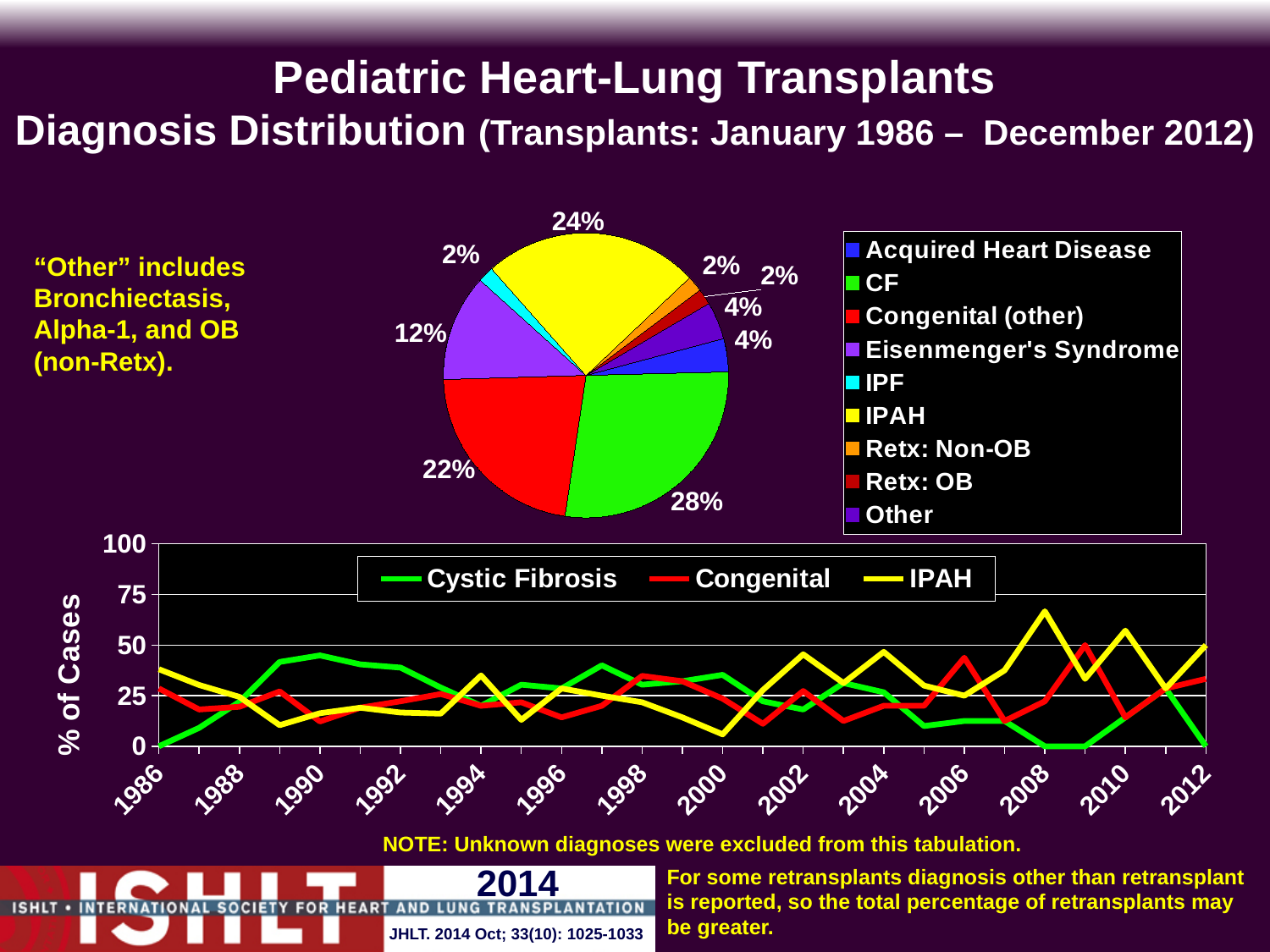
In the pie chart, which is larger, the share for Congenital (other) or the share for Eisenmenger's Syndrome? Congenital (other) In the pie chart, how many diagnosis categories does the legend list? 9 In the lower line chart, is the value for Cystic Fibrosis in 2012 greater or less than 25? less In the pie chart, which diagnosis has the largest share? CF What kind of chart is the lower chart showing % of Cases from 1986 to 2012? Line chart In the pie chart, what share of pediatric heart-lung transplants is attributed to CF? 28% In the pie chart, what is the difference between the CF share and the IPAH share? 4% In the pie chart, what percentage is shown for Eisenmenger's Syndrome? 12% In the lower line chart, is the value for IPAH in 2008 greater or less than 50? greater In the pie chart, what percentage is shown for Congenital (other)? 22% In the lower line chart, how many series does the legend list? 3 In the pie chart, what percentage is shown for IPAH? 24%